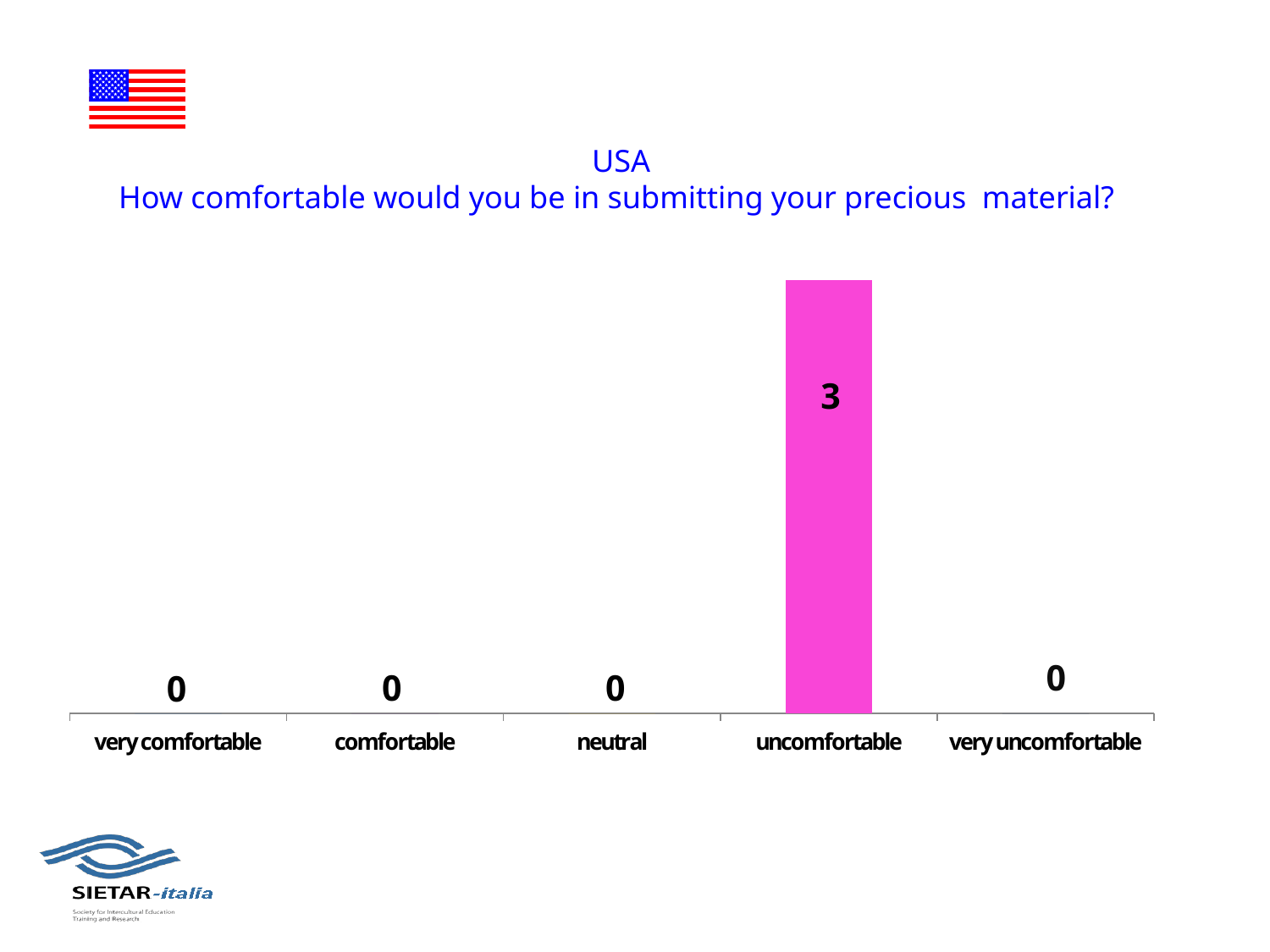
What is the value for "very uncomfortable"? 0 What colour is the bar for "uncomfortable"? pink What is the difference between the values for "uncomfortable" and "comfortable"? 3 How many categories are shown on the x axis? 5 What is the value for "neutral"? 0 What is the value for "uncomfortable"? 3 What is the total of all the values shown in the chart? 3 How many categories have a value of 0? 4 What kind of chart is shown on the slide? bar chart Which category has the highest value? uncomfortable What is the value for "very comfortable"? 0 Which is larger, the value for "uncomfortable" or the value for "neutral"? uncomfortable